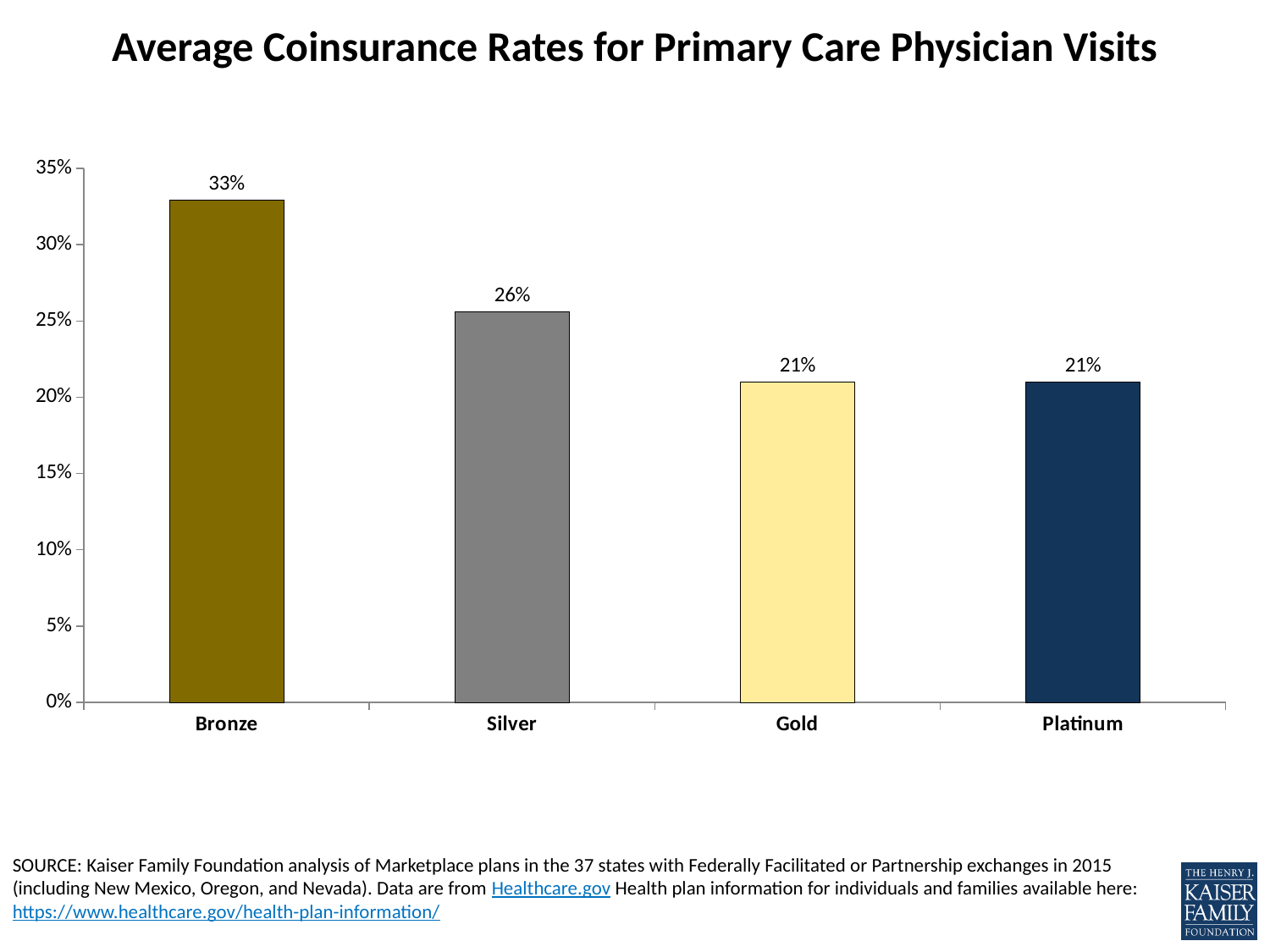
What is the average coinsurance rate for Platinum plans? 21% What is the difference between the Silver and Gold average coinsurance rates? 5% What is the average coinsurance rate for Silver plans? 26% What is the difference between the Bronze and Silver average coinsurance rates? 7% What is the title of the chart? Average Coinsurance Rates for Primary Care Physician Visits What is the average coinsurance rate for Bronze plans? 33% Is the value for Silver greater or less than 25%? greater What is the average coinsurance rate for Gold plans? 21% Which plan type has the highest average coinsurance rate? Bronze Which has a higher average coinsurance rate, Bronze or Silver? Bronze What kind of chart is shown on the slide? Bar chart How many plan types are shown on the chart? 4